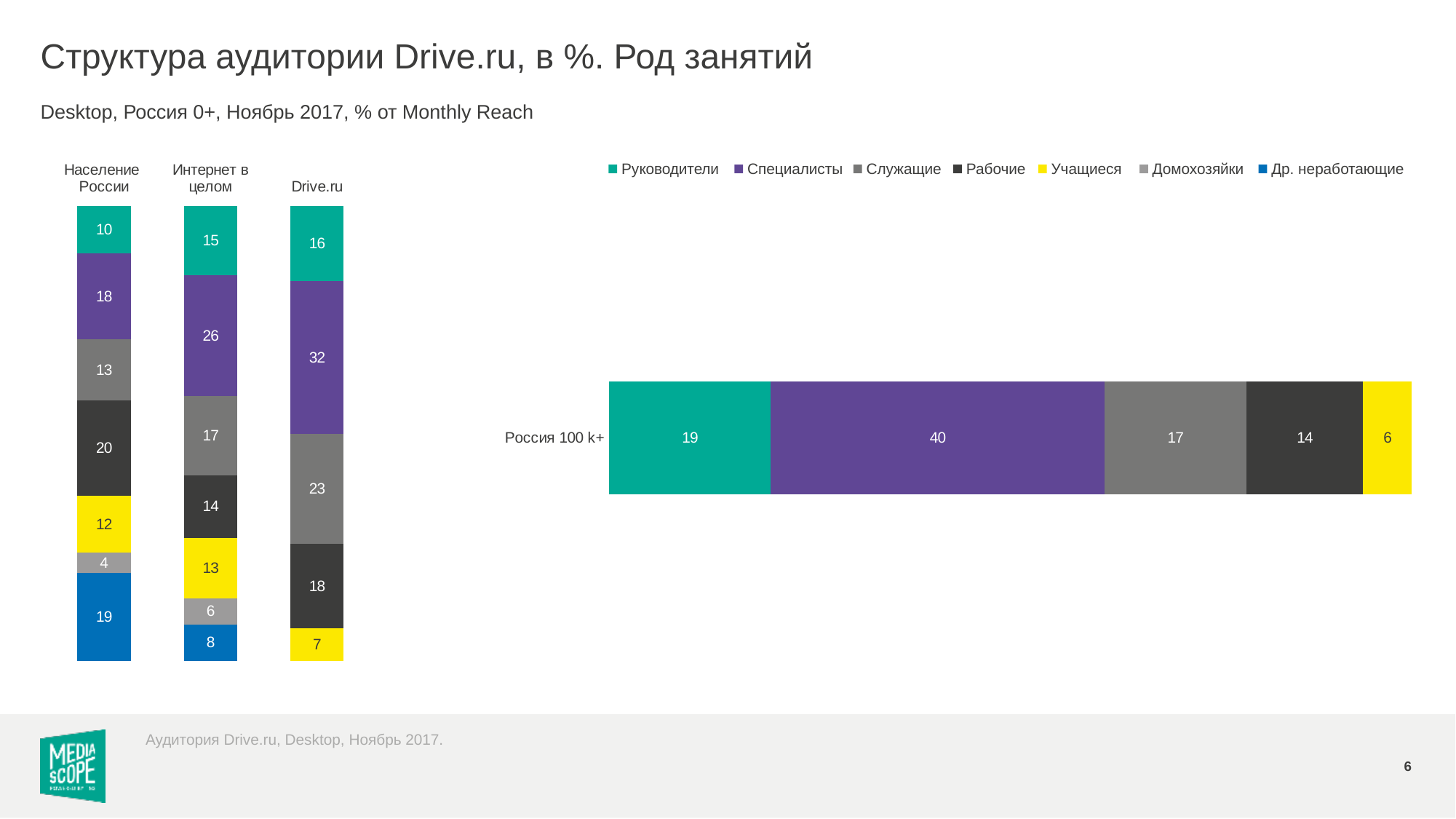
How many bars are shown in the left chart? 3 In the left chart, what is the value for Др. неработающие in the Население России bar? 19 In the right chart, what is the total of the Россия 100 k+ bar? 96 What kind of chart is the right chart (Россия 100 k+)? Stacked bar chart In the left chart, what is the difference between the Специалисты values for Drive.ru and Население России? 14 In the left chart, which segment is the largest in the Интернет в целом bar? Специалисты In the left chart, what is the value for Специалисты in the Drive.ru bar? 32 In the right chart (Россия 100 k+), what is the value for Специалисты? 40 In the left chart, which bar has the larger value for Руководители: Интернет в целом or Drive.ru? Drive.ru Which colour represents Учащиеся in the legend? Yellow In the right chart (Россия 100 k+), which segment is the smallest? Учащиеся How many series does the legend list? 7